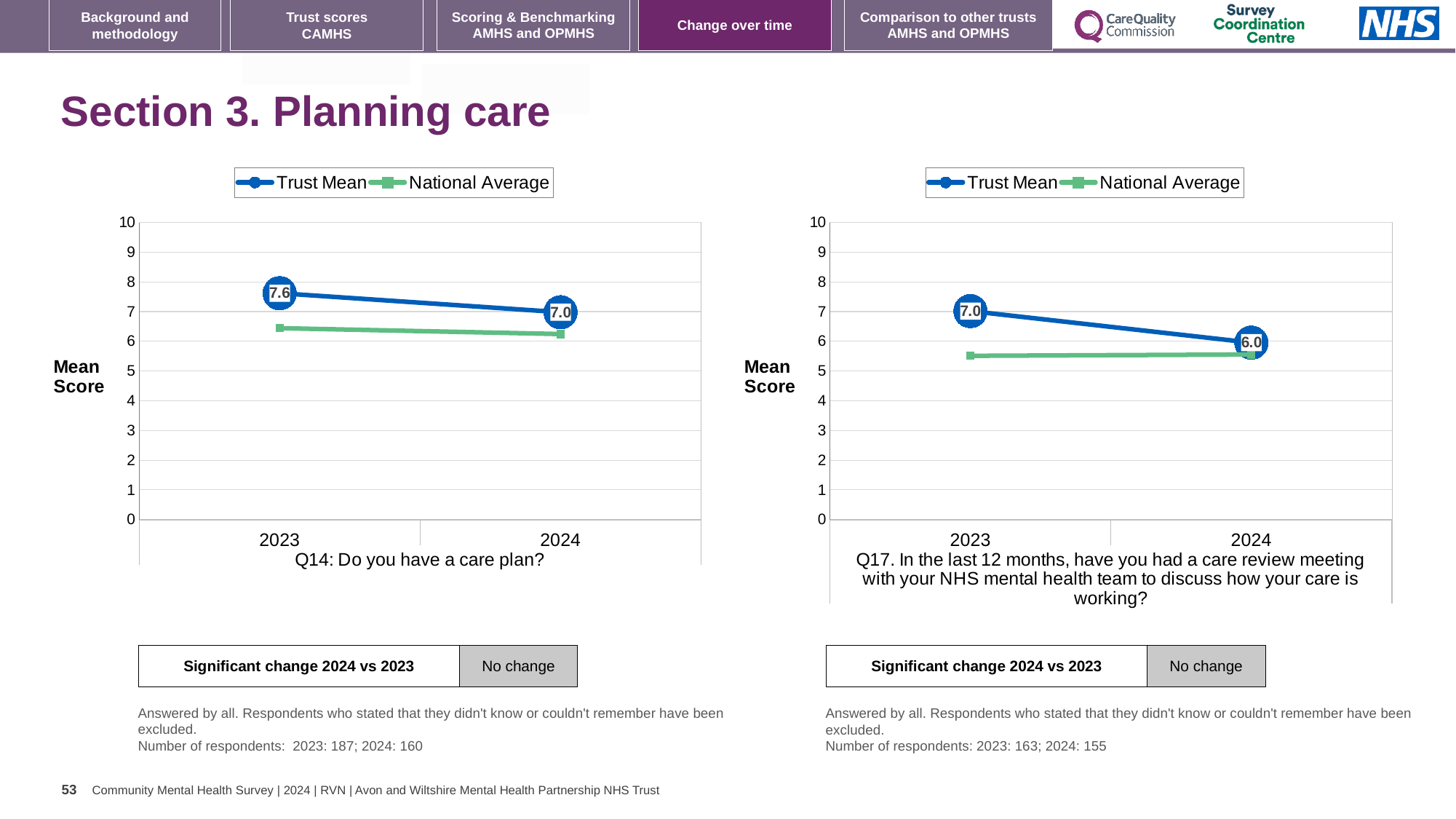
In the left chart (Q14), does the Trust Mean rise or fall from 2023 to 2024? fall In the right chart (Q17), is the National Average for 2023 greater or less than 6? less In the right chart (Q17, care review meeting), what is the Trust Mean for 2024? 6.0 How many series does the legend of the left chart list? 2 In the left chart (Q14), is the National Average for 2024 greater or less than 7? less In the right chart (Q17), which series has the higher value in 2023, Trust Mean or National Average? Trust Mean What type of chart is the right chart (Q17)? line chart In the right chart (Q17, care review meeting), what is the Trust Mean for 2023? 7.0 In the right chart (Q17), what is the difference between the Trust Mean in 2023 and in 2024? 1.0 In the left chart (Q14), what is the difference between the Trust Mean in 2023 and in 2024? 0.6 In the left chart (Q14: Do you have a care plan?), what is the Trust Mean for 2024? 7.0 In the left chart (Q14: Do you have a care plan?), what is the Trust Mean for 2023? 7.6